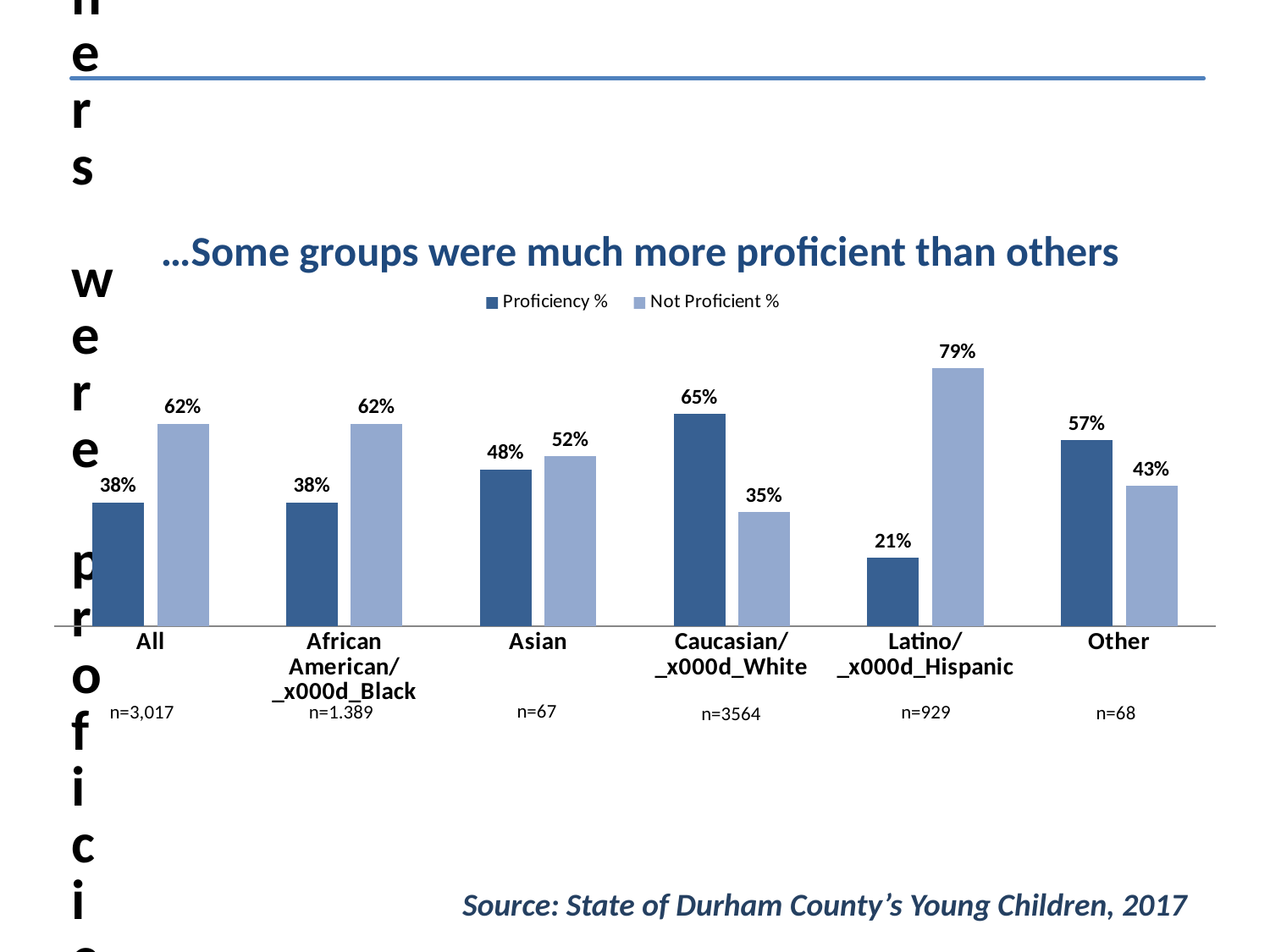
What kind of chart is shown on the slide? Bar chart What is the difference between the Not Proficient % and Proficiency % values for Other? 14% What is the Proficiency % value for Asian? 48% How many series does the legend list? 2 How many categories are shown on the x axis? 6 Which category has the highest Proficiency % value? Caucasian/White Which is larger for Asian: Proficiency % or Not Proficient %? Not Proficient % What is the Proficiency % value for Caucasian/White? 65% What is the title of the chart? …Some groups were much more proficient than others What is the Not Proficient % value for Latino/Hispanic? 79% What is the sample size (n) shown for the All category? n=3,017 Which category has the lowest Proficiency % value? Latino/Hispanic